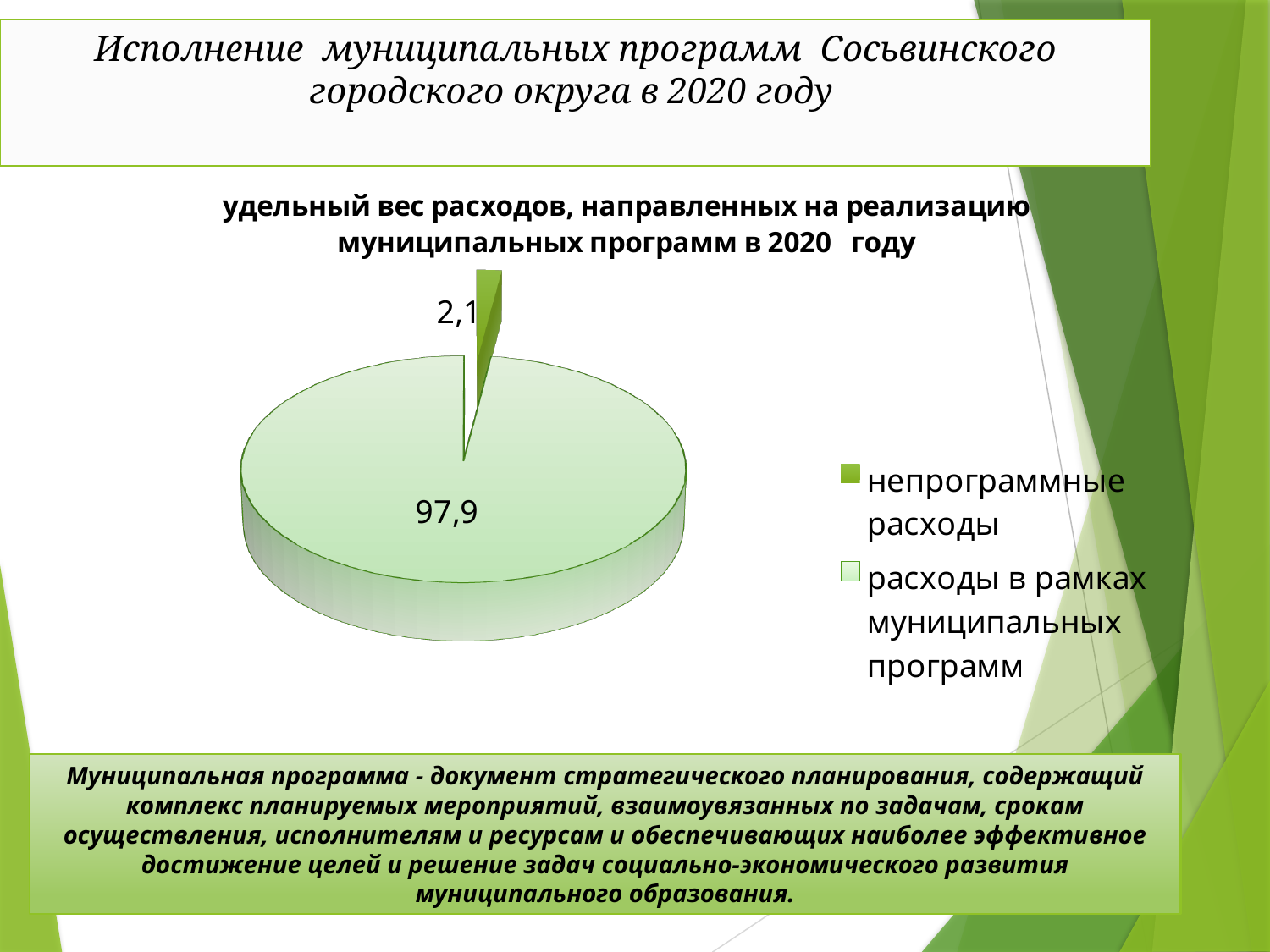
Which legend entry is shown in the darker green colour? непрограммные расходы What is the value for "непрограммные расходы"? 2,1 How many slices does the pie chart have? 2 What is the value for "расходы в рамках муниципальных программ"? 97,9 What is the title of the chart? удельный вес расходов, направленных на реализацию муниципальных программ в 2020 году Which category has the smallest share of the pie? непрограммные расходы How many entries does the legend list? 2 What kind of chart is shown on the slide? pie chart What is the difference between the values for "расходы в рамках муниципальных программ" and "непрограммные расходы"? 95,8 Which is larger: "непрограммные расходы" or "расходы в рамках муниципальных программ"? расходы в рамках муниципальных программ Which category has the largest share of the pie? расходы в рамках муниципальных программ